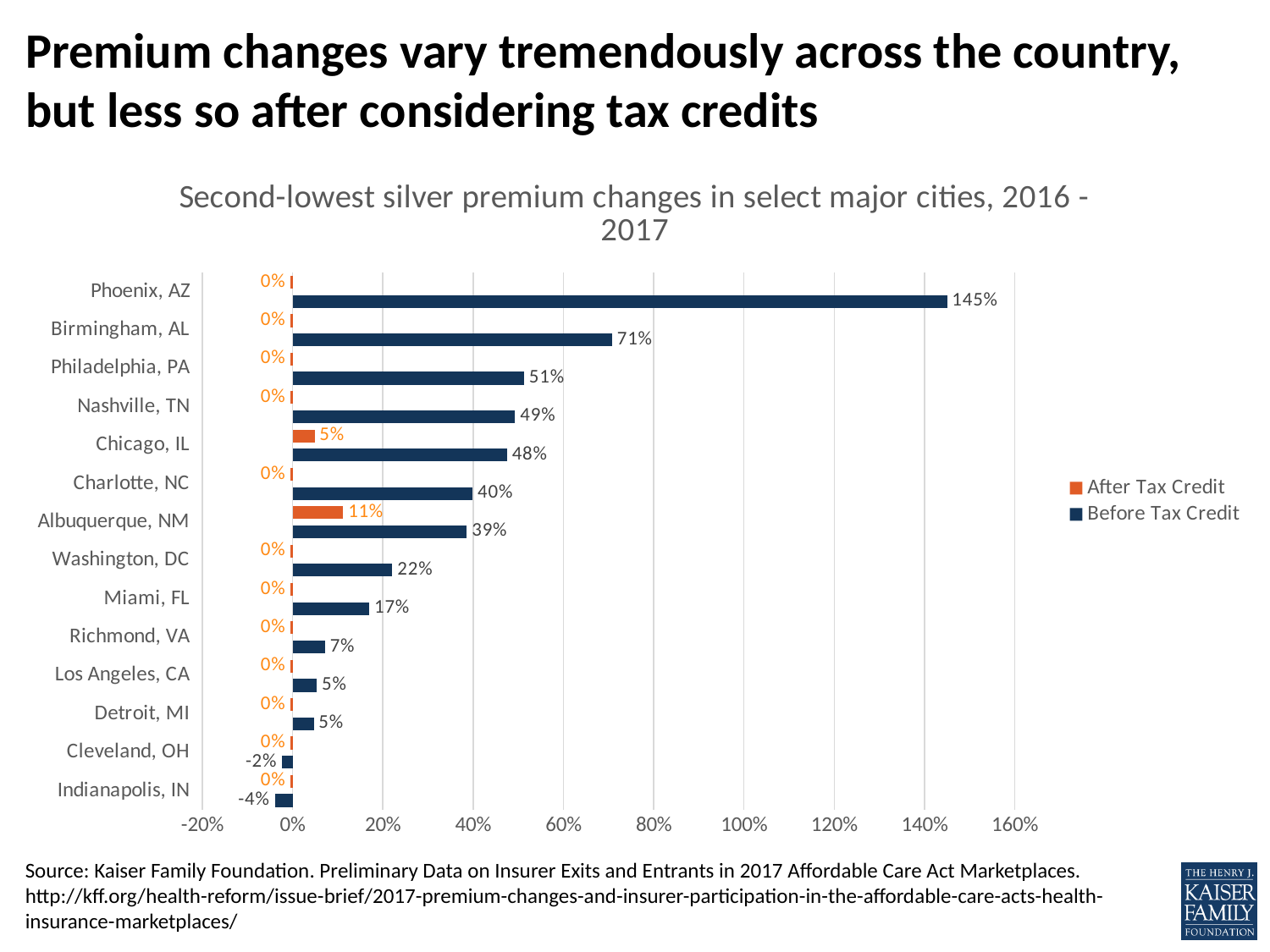
Which colour represents the After Tax Credit series in the chart? Orange What is the After Tax Credit premium change for Albuquerque, NM? 11% What is the Before Tax Credit premium change for Indianapolis, IN? -4% Which is larger, the Before Tax Credit premium change for Washington, DC or for Miami, FL? Washington, DC Which city has the highest Before Tax Credit premium change? Phoenix, AZ What kind of chart is shown on the slide? Bar chart How many cities are shown in the chart? 14 Which city has the lowest Before Tax Credit premium change? Indianapolis, IN What is the After Tax Credit premium change for Chicago, IL? 5% How many series does the legend list? 2 What is the Before Tax Credit premium change for Phoenix, AZ? 145% What is the difference between the Before Tax Credit premium changes for Phoenix, AZ and Birmingham, AL? 74%